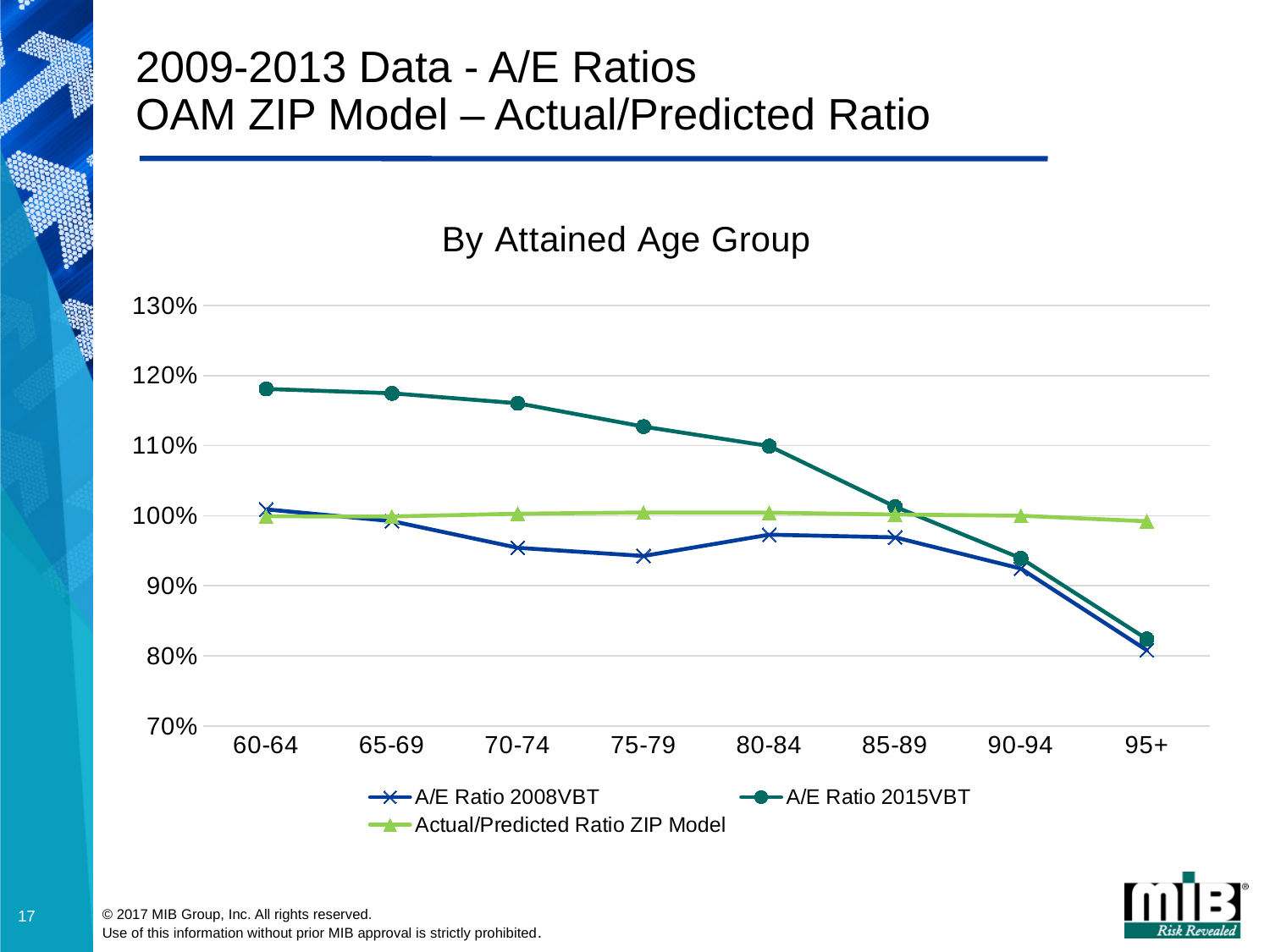
For which age group is the A/E Ratio 2015VBT lowest? 95+ What kind of chart is shown on the slide? Line chart At 90-94, which is larger: A/E Ratio 2015VBT or Actual/Predicted Ratio ZIP Model? Actual/Predicted Ratio ZIP Model How many series does the legend list? 3 Is the A/E Ratio 2015VBT value for 60-64 greater or less than 110%? greater At 60-64, which is larger: A/E Ratio 2015VBT or A/E Ratio 2008VBT? A/E Ratio 2015VBT Is the A/E Ratio 2008VBT value for 70-74 greater or less than 100%? less How many attained age groups are shown on the x axis? 8 Does the A/E Ratio 2015VBT series rise or fall as attained age increases? Fall Is the A/E Ratio 2008VBT value for 95+ greater or less than 90%? less What is the title of the chart? By Attained Age Group Which series is plotted with triangle markers? Actual/Predicted Ratio ZIP Model